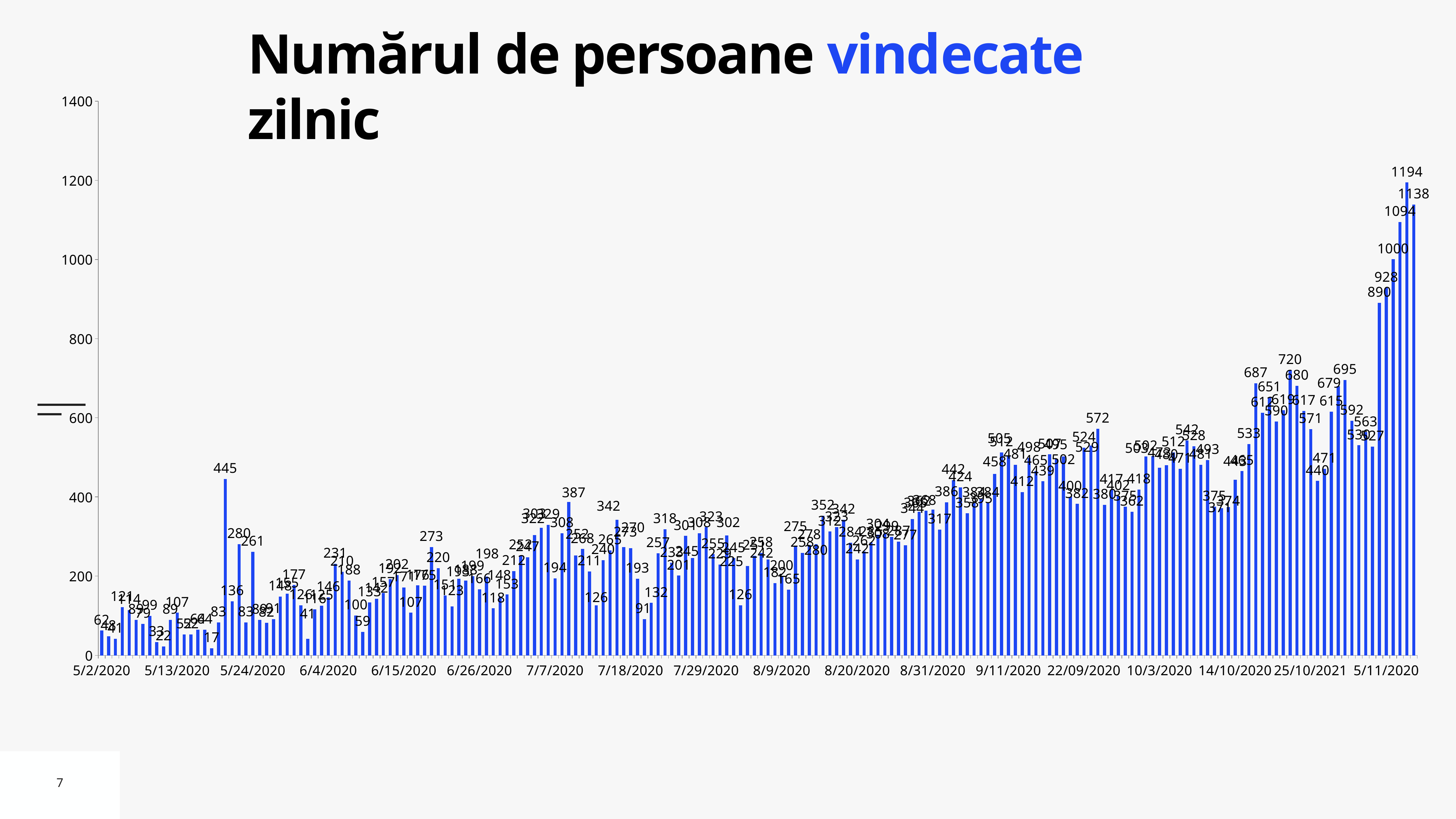
What is the value of the last bar in the chart? 1138 What is the maximum value shown on the vertical axis? 1400 What kind of chart is shown on the slide? bar chart Is the first bar, at 5/2/2020, greater or less than 200? less Is the highest bar in the chart greater or less than 1000? greater Overall, do the values rise or fall from left to right along the x axis? rise What is the highest value shown in the chart? 1194 What is the difference between the highest bar (1194) and the last bar (1138)? 56 What is the title of the chart? Numărul de persoane vindecate zilnic What is the value of the first bar, at 5/2/2020? 62 What is the lowest value shown in the chart? 17 Which is larger, the bar labelled 445 in May or the bar labelled 387 in July? 445